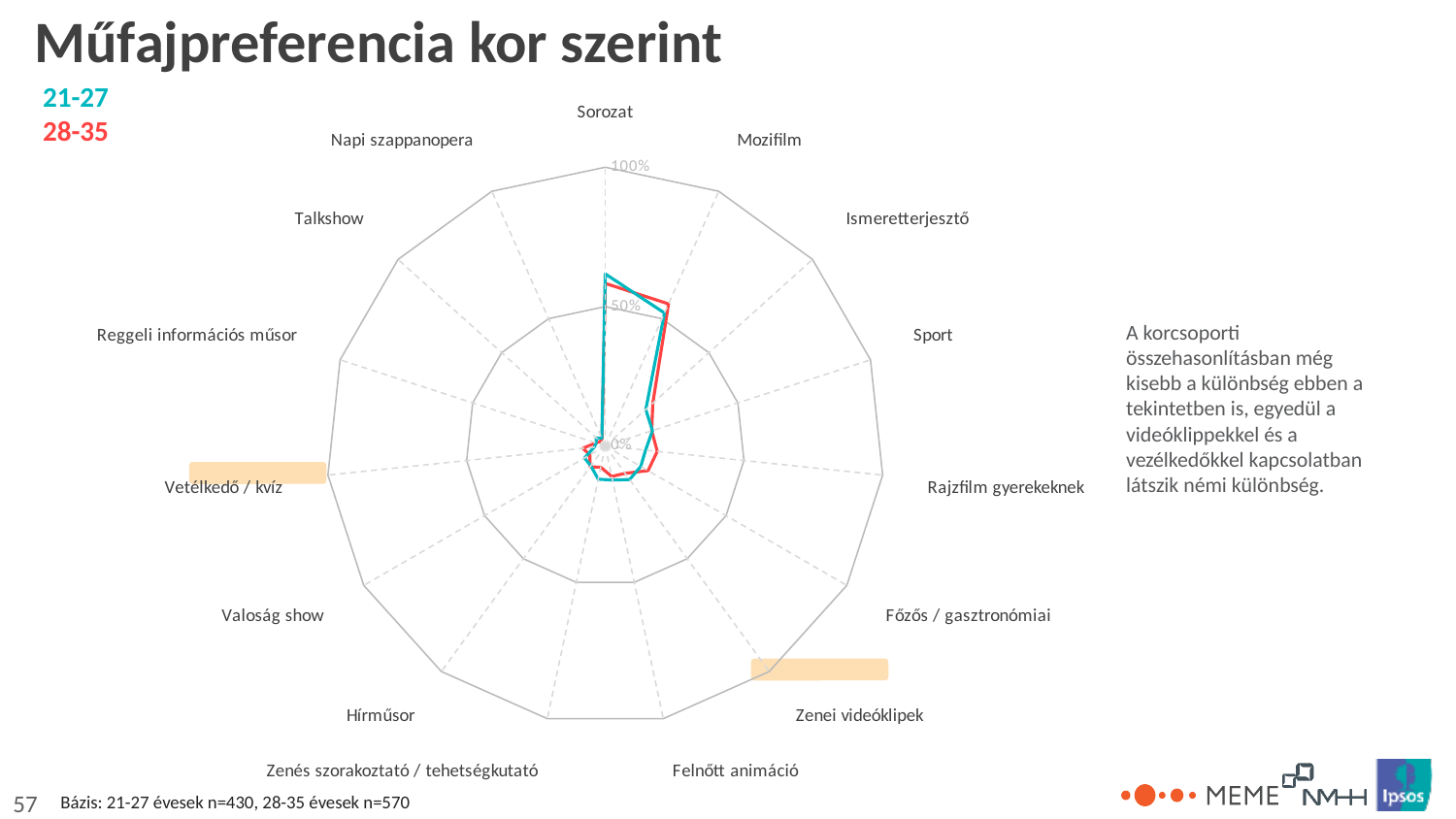
Is the value for Sorozat in the 21-27 group greater or less than 50%? greater Is the value for Hírműsor in the 28-35 group greater or less than 50%? less For the 21-27 group, which is larger: the value for Sorozat or the value for Sport? Sorozat What is the title of the chart? Műfajpreferencia kor szerint Is the value for Vetélkedő / kvíz in the 21-27 group greater or less than 50%? less For the 28-35 group, which is larger: the value for Mozifilm or the value for Valoság show? Mozifilm What kind of chart is shown on the slide? Radar chart What is the maximum value shown on the radar chart's axis? 100% How many series does the legend list? 2 How many genre categories are plotted around the radar chart? 15 Which two age groups are compared in the chart? 21-27 and 28-35